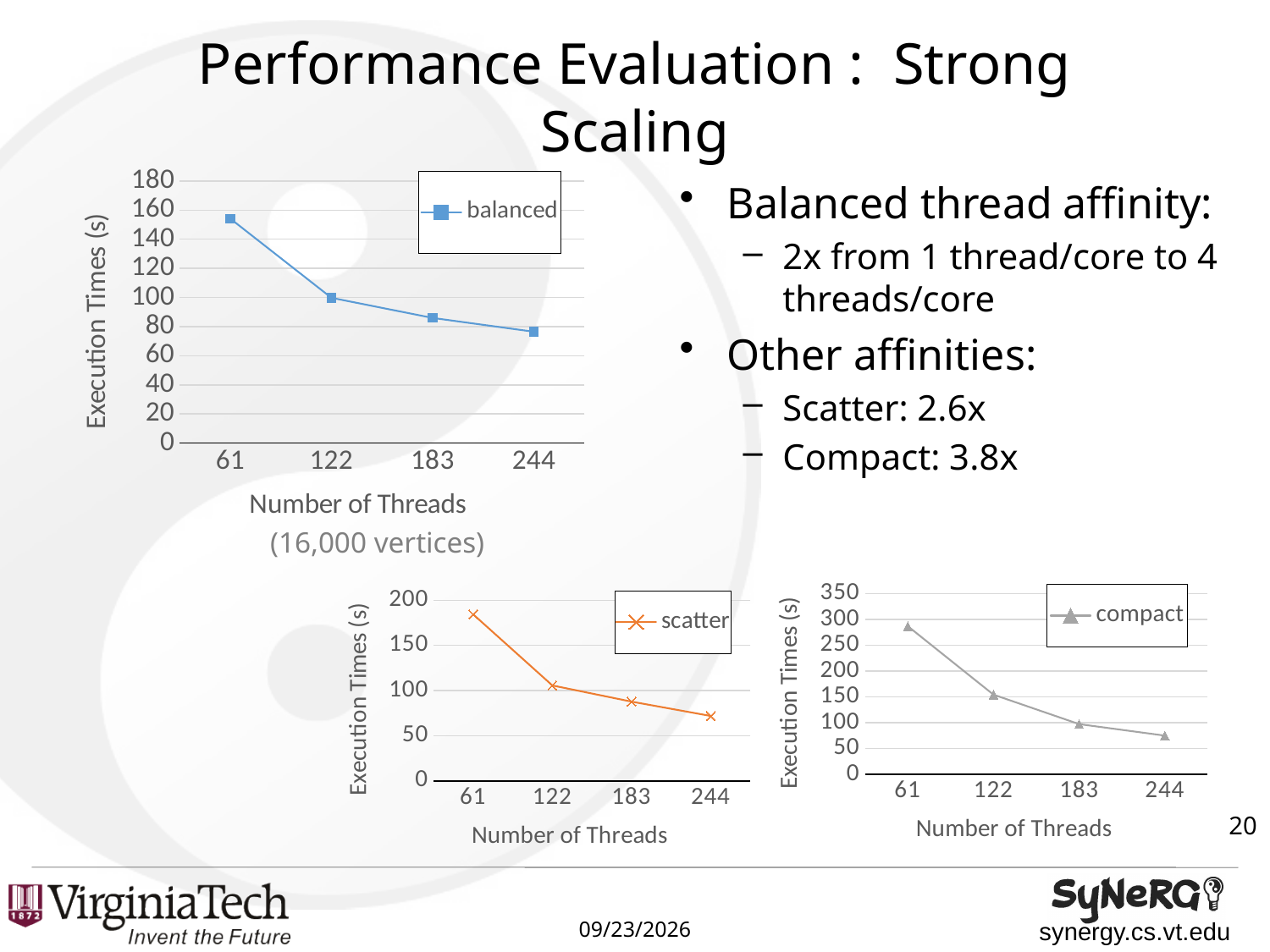
In the top-left chart (balanced), which number of threads has the lowest execution time? 244 In the top-left chart (balanced), how many series does the legend list? 1 In the top-left chart (balanced), how many thread counts are plotted on the x axis? 4 What is the y-axis title of the bottom-right chart (compact)? Execution Times (s) In the bottom-middle chart (scatter), which number of threads has the highest execution time? 61 In the bottom-right chart (compact), is the execution time at 244 threads greater or less than 100? less In the bottom-right chart (compact), is the execution time at 61 threads greater or less than 250? greater In the top-left chart (balanced), what kind of chart is shown? line chart In the top-left chart (balanced), do execution times rise or fall as the number of threads increases? fall In the bottom-right chart (compact), which is larger: the execution time at 122 threads or at 183 threads? 122 threads In the top-left chart (balanced), is the execution time at 61 threads greater or less than 140? greater